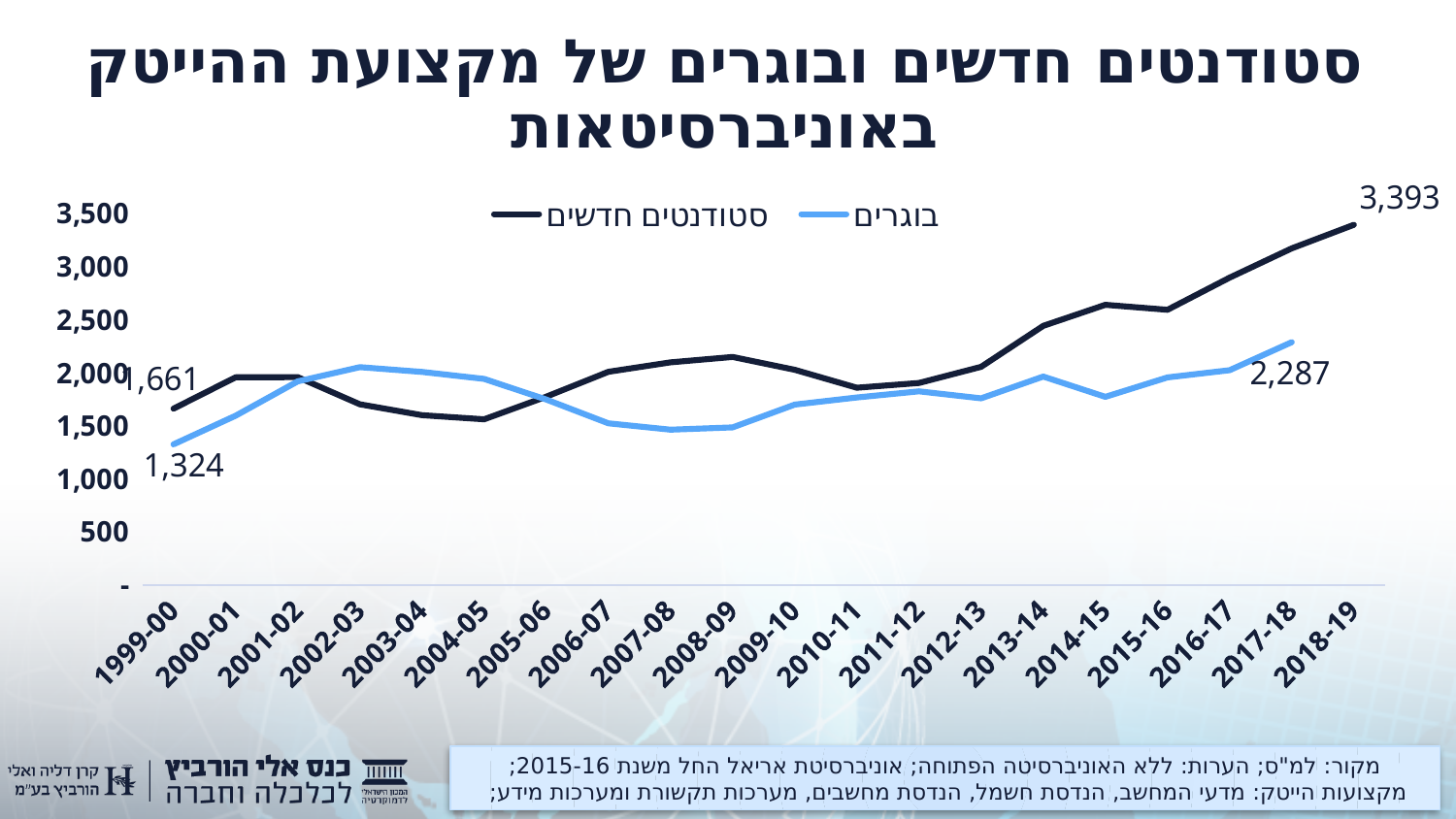
What kind of chart is shown on the slide? Line chart Is the value for new students in 2013-14 greater or less than 2,000? greater What is the value for new students (סטודנטים חדשים) in 2018-19? 3,393 How many academic years are shown on the x axis? 20 What is the value for new students (סטודנטים חדשים) in 1999-00? 1,661 How many series does the legend list? 2 By how much did the number of new students grow from 1999-00 to 2018-19? 1,732 What is the value for graduates (בוגרים) in 1999-00? 1,324